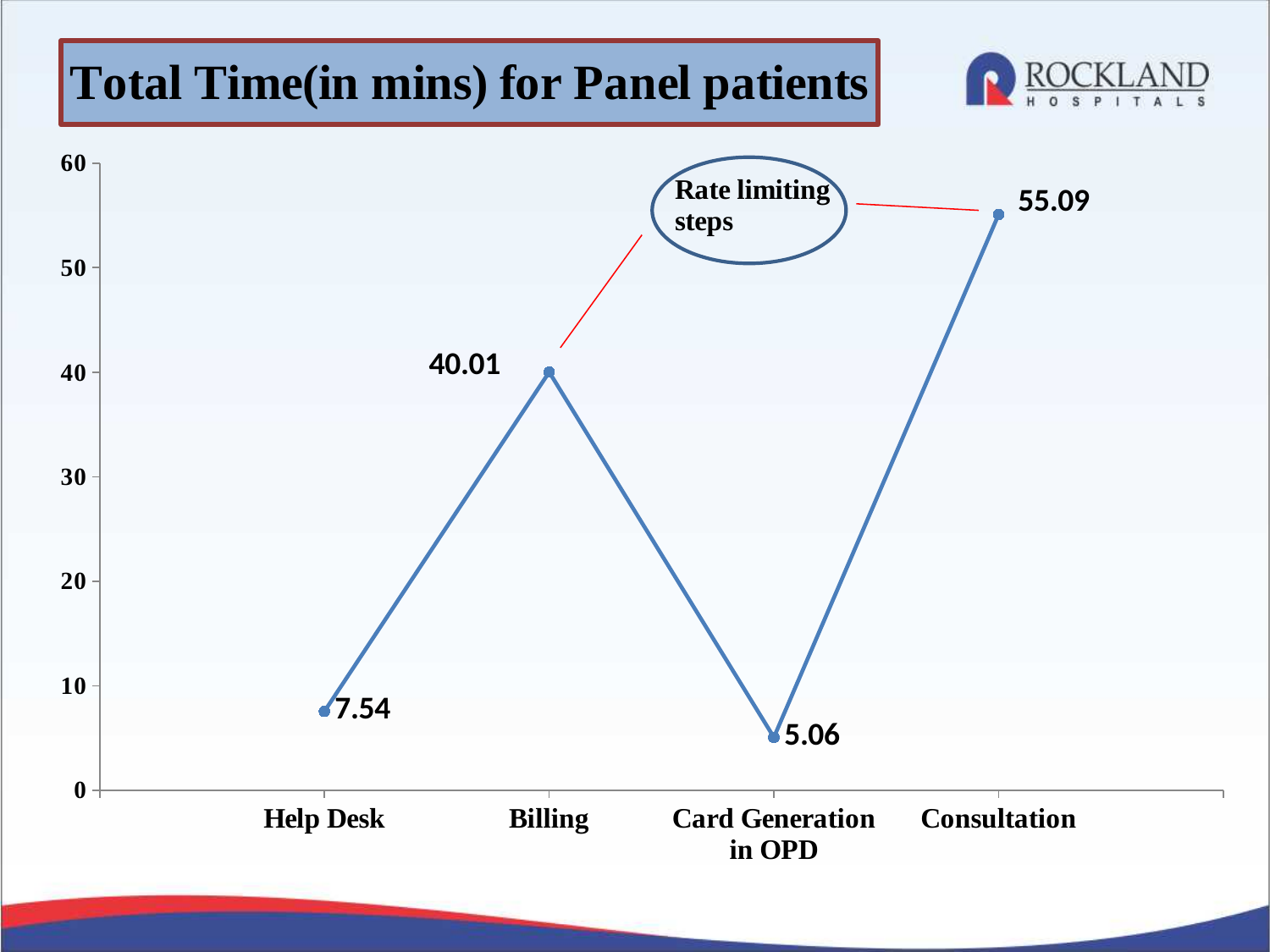
Which step has the highest total time? Consultation Which takes more time, Billing or Help Desk? Billing What does the circled annotation on the chart say? Rate limiting steps What is the difference in minutes between Consultation and Billing? 15.08 What is the total time in minutes for Billing? 40.01 Which step has the lowest total time? Card Generation in OPD How many steps are plotted on the chart? 4 Is the value for Consultation greater or less than 50? greater What is the difference in minutes between Help Desk and Card Generation in OPD? 2.48 What is the total time in minutes for Card Generation in OPD? 5.06 What is the total time in minutes for Help Desk? 7.54 What kind of chart is shown on the slide? Line chart